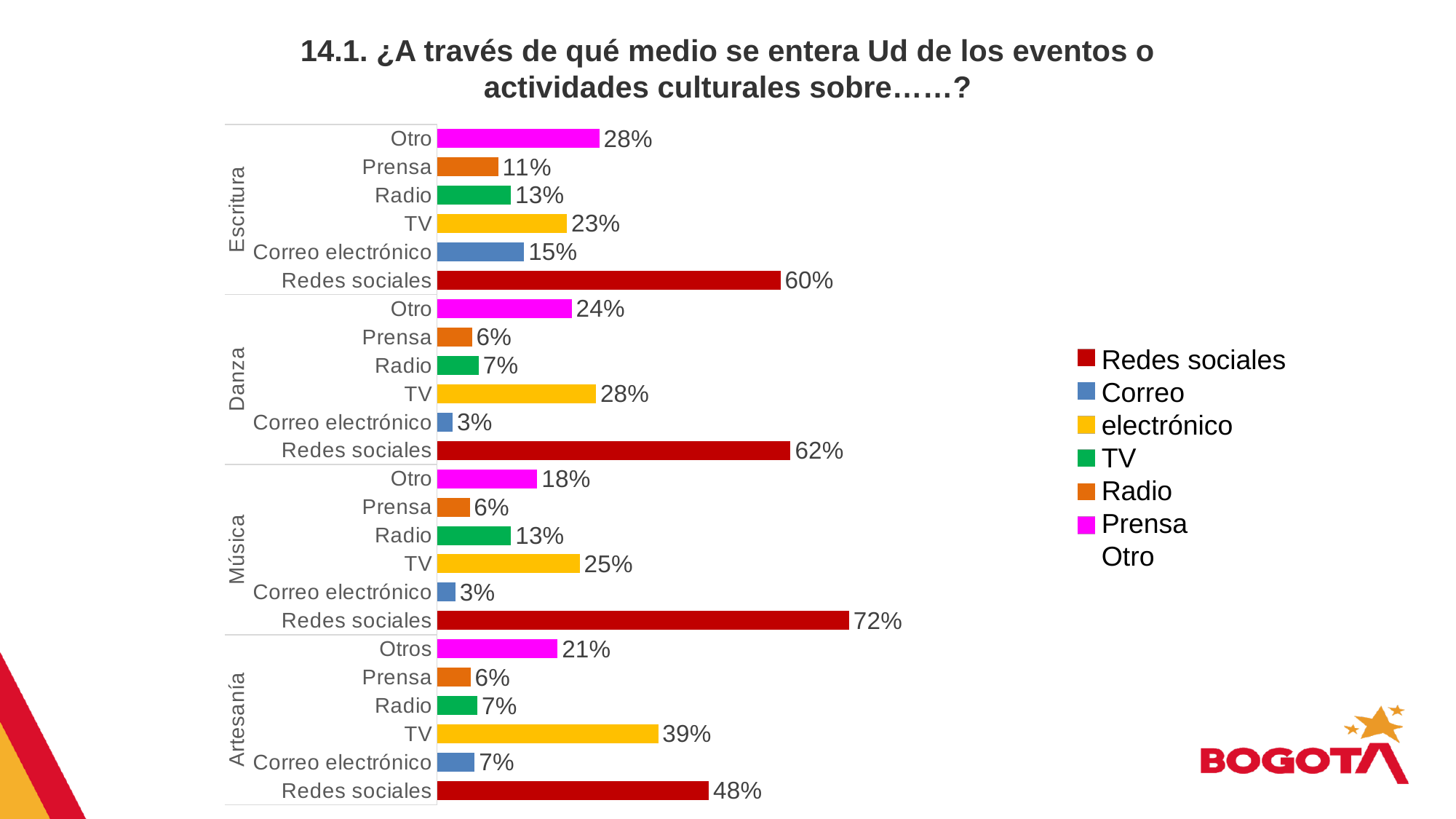
Which medium has the highest value in the Danza group? Redes sociales What is the difference between Redes sociales and TV in the Escritura group? 37% Which is larger in the Artesanía group, TV or Otros? TV Which group has the highest value for Redes sociales? Música Which medium has the lowest value in the Música group? Correo electrónico What is the value for TV in the Artesanía group? 39% How many entries does the legend list? 6 How many bars are plotted in the chart in total? 24 What is the value for Redes sociales in the Música group? 72% How many groups (categories on the left axis) does the chart show? 4 What kind of chart is shown on the slide? Bar chart What is the value for Correo electrónico in the Escritura group? 15%